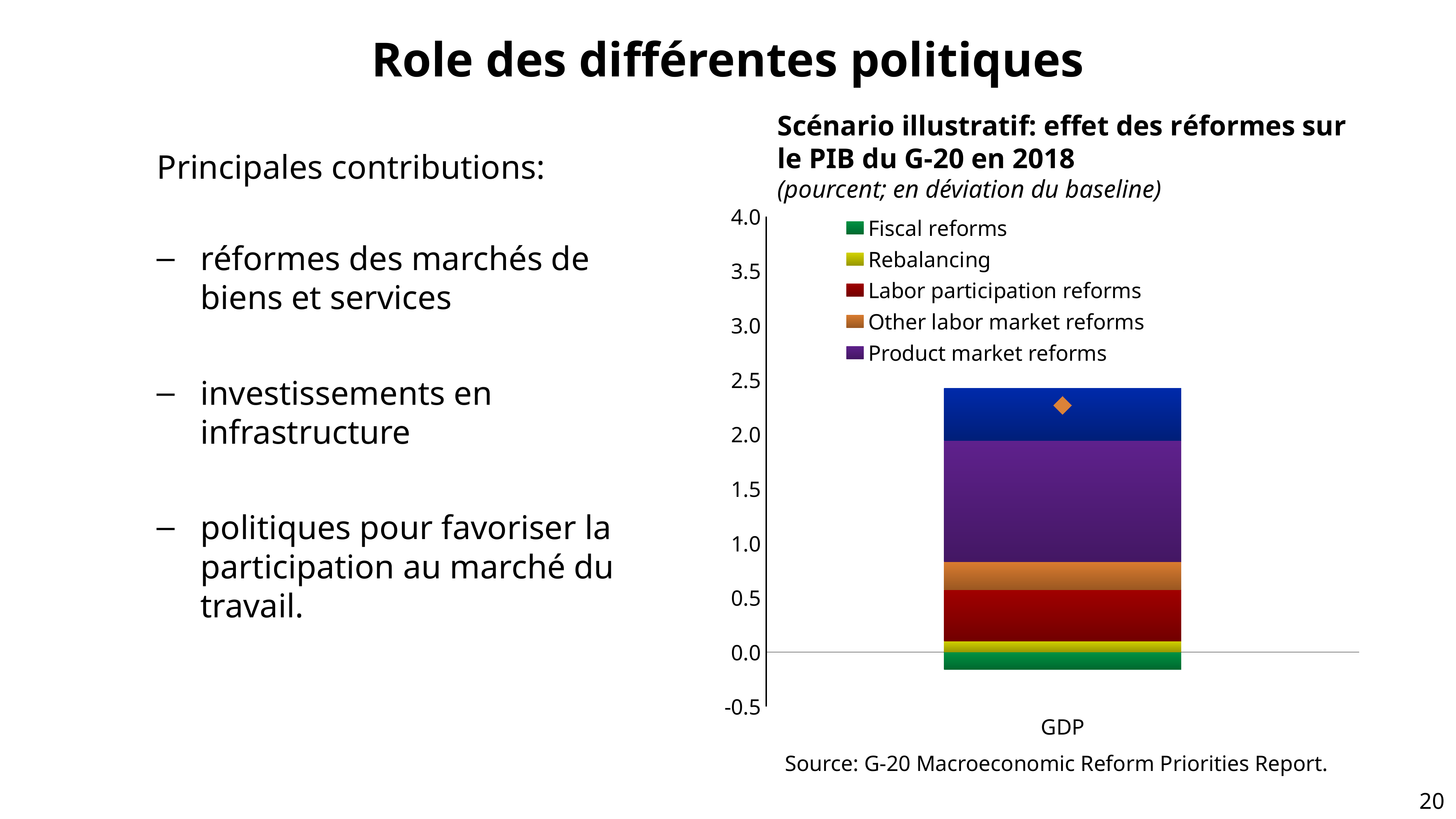
Which legend series contributes the largest segment to the GDP bar? Product market reforms Is the top of the stacked GDP bar greater or less than 3.0? less How many categories are shown on the x axis of the chart? 1 Which segment is larger in the GDP bar: Product market reforms or Labor participation reforms? Product market reforms What kind of chart is shown on the slide? Stacked bar chart Which segment is larger in the GDP bar: Labor participation reforms or Other labor market reforms? Labor participation reforms What is the label of the single category on the x axis? GDP Is the Fiscal reforms contribution to GDP greater or less than 0.0? less How many series does the chart's legend list? 5 What is the source cited below the chart? G-20 Macroeconomic Reform Priorities Report. Which series in the legend is shown in purple? Product market reforms Is the top of the stacked GDP bar greater or less than 2.0? greater